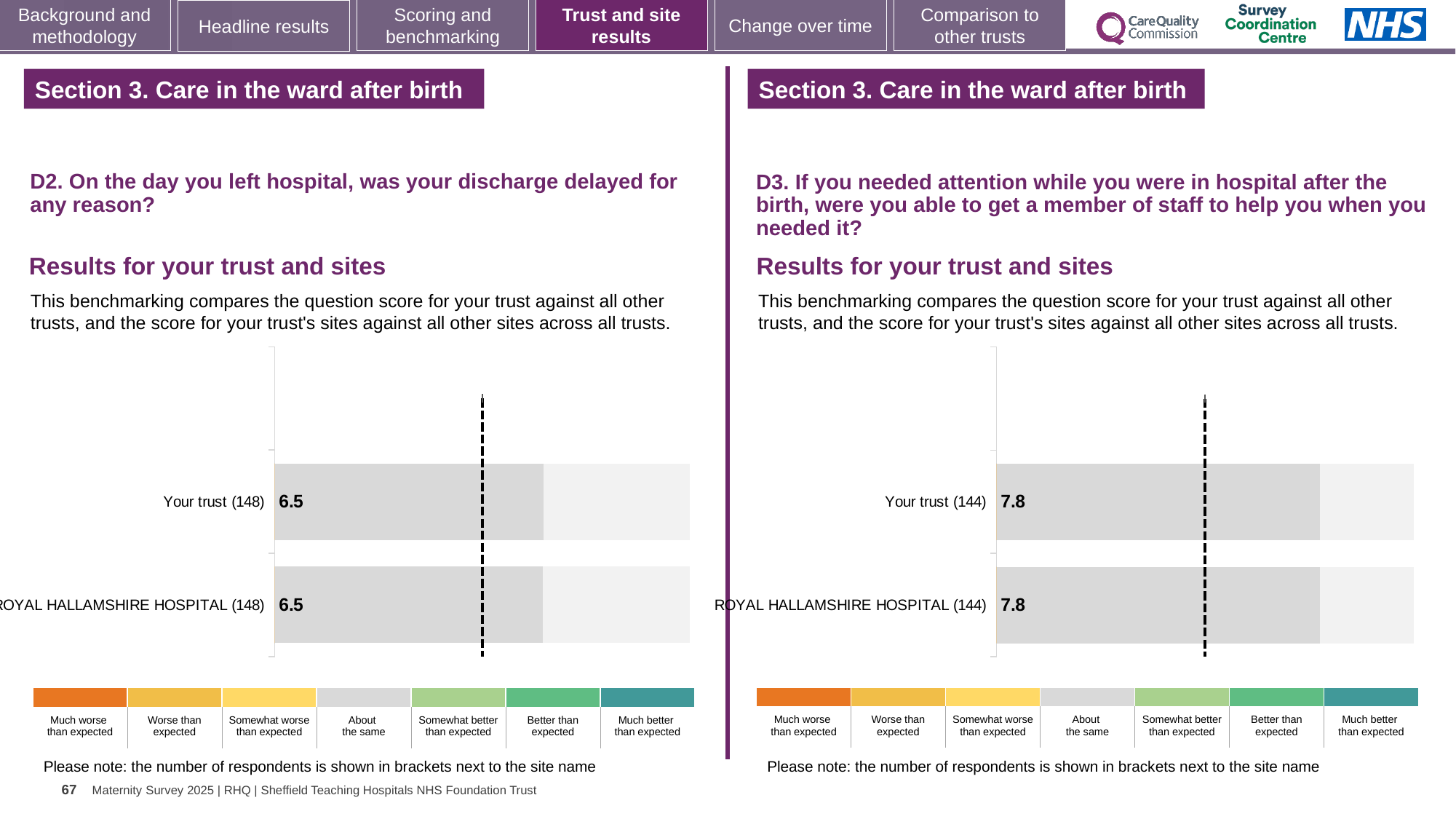
How many bars are plotted in the D2 chart (left)? 2 In the D2 chart (left), what is the score for ROYAL HALLAMSHIRE HOSPITAL? 6.5 In the D3 chart (right), what is the score for ROYAL HALLAMSHIRE HOSPITAL? 7.8 Which is larger: the Your trust score in the D3 chart (right) or the Your trust score in the D2 chart (left)? D3 chart (right) In the D3 chart (right), what is the score for Your trust? 7.8 In the D2 chart (left), how many respondents are shown in brackets next to Your trust? 148 How many categories does the colour legend below the D3 chart (right) list? 7 In the D2 chart (left), what is the score for Your trust? 6.5 How many bars are plotted in the D3 chart (right)? 2 What type of chart is used in the D2 chart (left)? Bar chart What is the difference between the Your trust score in the D3 chart (right) and the Your trust score in the D2 chart (left)? 1.3 In the D2 chart (left), what is the difference between the score for Your trust and the score for ROYAL HALLAMSHIRE HOSPITAL? 0